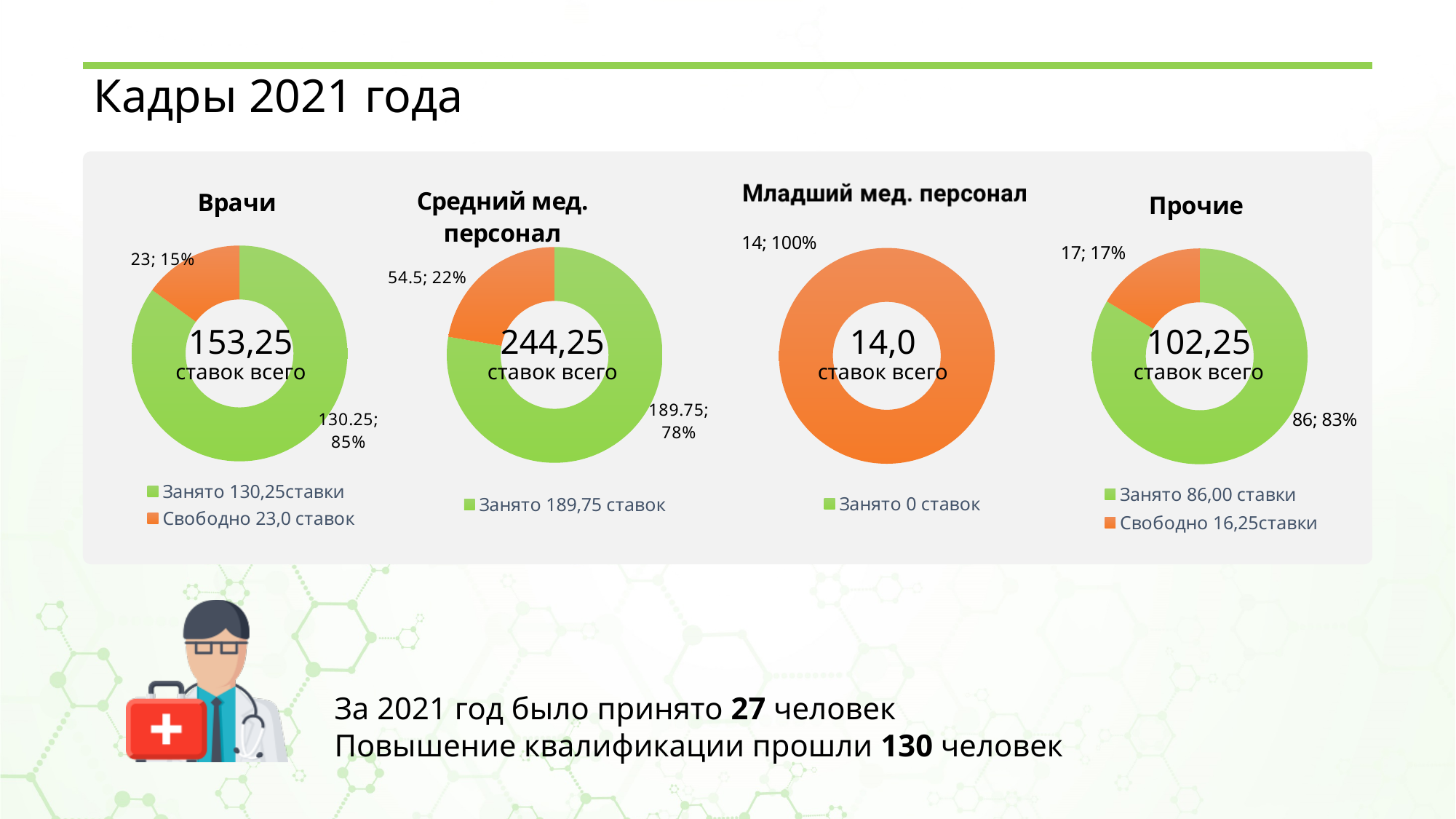
On the 'Врачи' chart, what is the data label for the green (occupied) slice? 130.25; 85% On the 'Средний мед. персонал' chart, what is the difference between the green slice value (189.75) and the orange slice value (54.5)? 135.25 What type of chart is used for 'Врачи'? donut (pie) chart On the 'Средний мед. персонал' chart, what percentage is shown for the orange slice? 22% How many entries does the legend of the 'Прочие' chart list? 2 On the 'Врачи' chart, what total number of positions is shown in the centre of the donut? 153,25 On the 'Врачи' chart, which slice is larger, the green one or the orange one? green On the 'Младший мед. персонал' chart, what share does the single orange slice represent? 100% On the 'Прочие' chart, what is the data label for the green slice? 86; 83% On the 'Прочие' chart, what percentage is shown for the orange slice? 17% On the 'Средний мед. персонал' chart, what total is shown in the centre of the donut? 244,25 How many donut charts are shown on the slide? 4